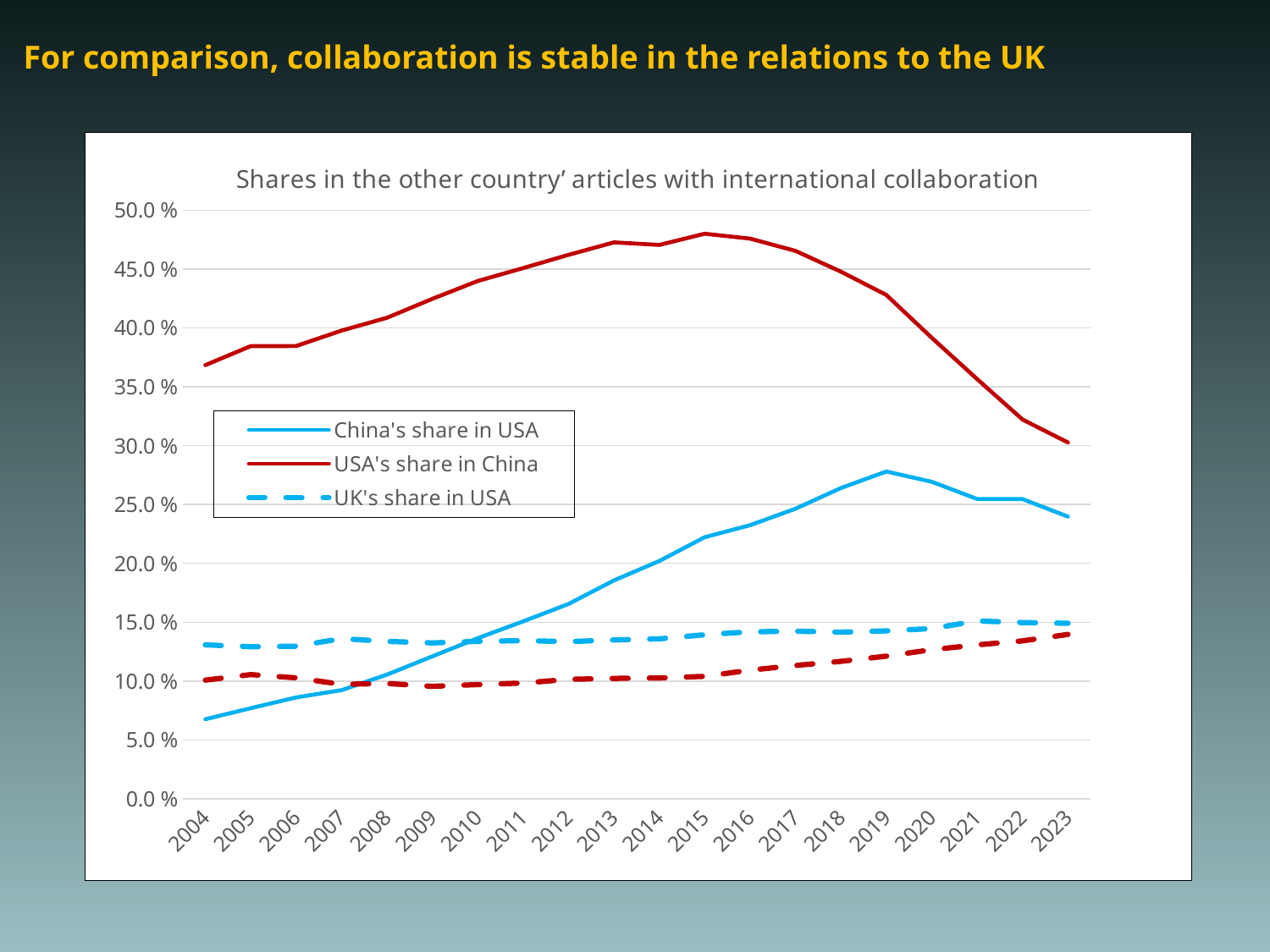
Is the value for China's share in USA in 2023 greater or less than 20.0 %? greater Is the value for UK's share in USA in 2023 greater or less than 20.0 %? less What is the title of the chart? Shares in the other country' articles with international collaboration In 2023, which is larger: China's share in USA or UK's share in USA? China's share in USA Does USA's share in China rise or fall between 2015 and 2023? fall How many years are shown on the x axis of the chart? 20 Is the value for USA's share in China in 2015 greater or less than 45.0 %? greater In which year is USA's share in China at its highest? 2015 What kind of chart is shown on the slide? line chart How many series does the chart's legend list? 3 In which year is China's share in USA at its highest? 2019